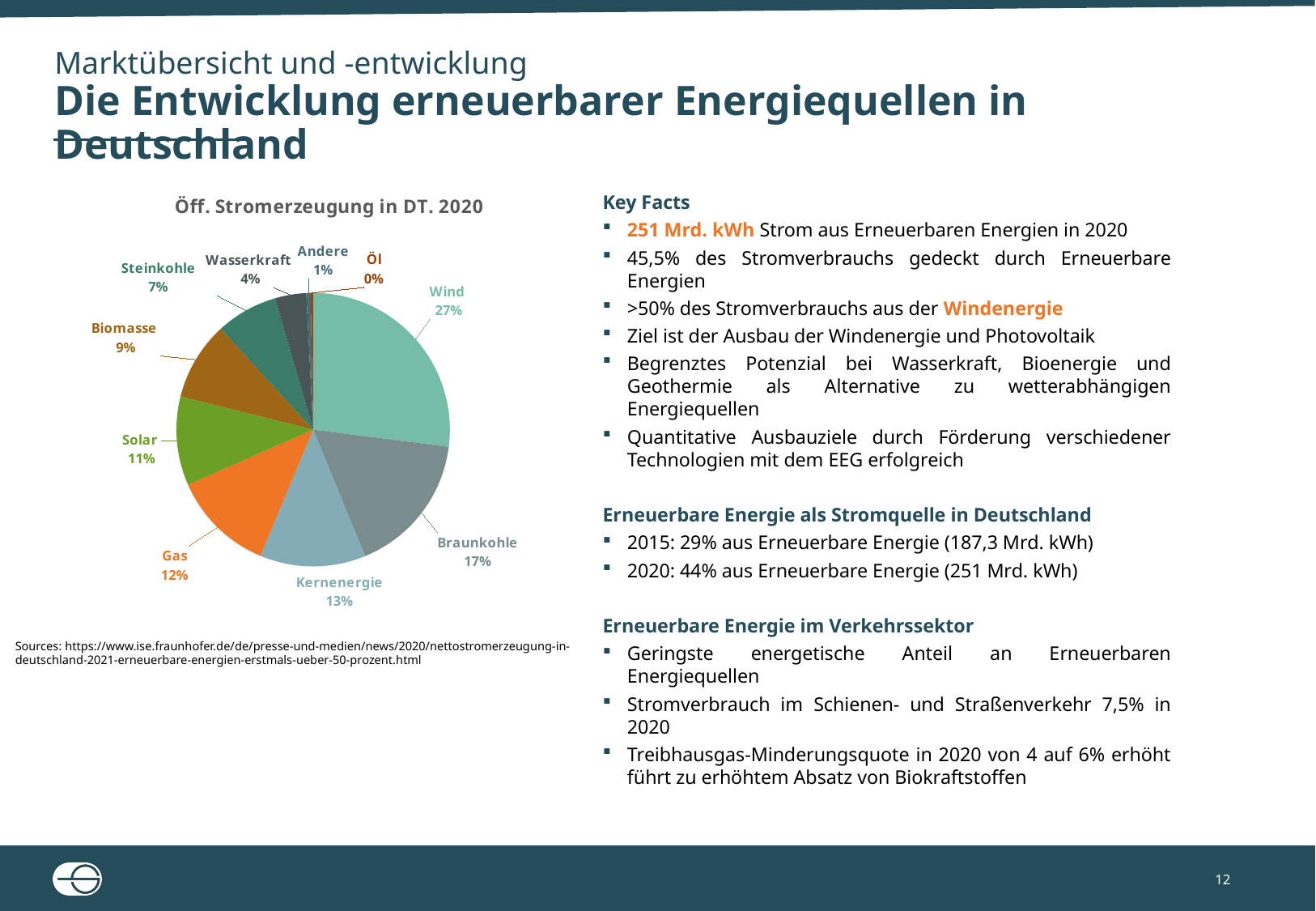
Which category has the largest slice of the pie? Wind Which category has the smallest slice of the pie? Öl What share of the pie does Wind have? 27% What is the combined share of Solar and Biomasse? 20% What is the value shown for Kernenergie? 13% Which is larger, the share for Gas or the share for Solar? Gas What type of chart is shown on the slide? pie chart What is the difference between the shares of Wind and Braunkohle? 10% What is the title of the chart? Öff. Stromerzeugung in DT. 2020 How many categories are shown in the pie chart? 10 What is the value shown for Wasserkraft? 4% What is the value shown for Braunkohle? 17%